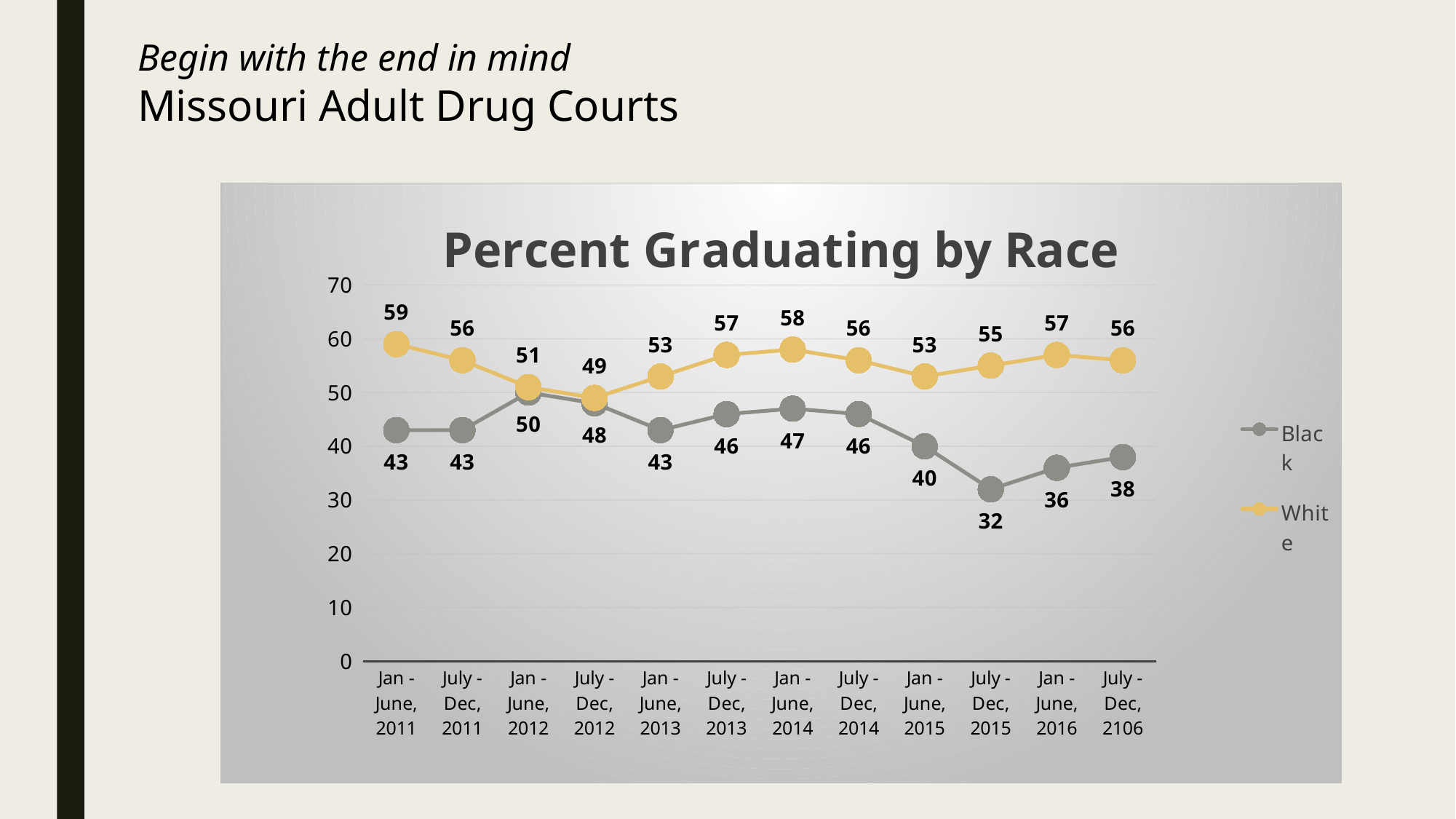
What is the value for Black in July - Dec, 2015? 32 What is the value for White in Jan - June, 2011? 59 How many series does the legend list? 2 What kind of chart is shown on the slide? line chart Does the Black series rise or fall from Jan - June, 2014 to July - Dec, 2015? fall In which period is the Black series at its lowest? July - Dec, 2015 How many time periods are plotted along the x axis? 12 Which series has the higher value in July - Dec, 2012, Black or White? White What is the difference between the White and Black values in July - Dec, 2015? 23 In which period is the White series at its lowest? July - Dec, 2012 What is the value for Black in Jan - June, 2012? 50 What is the chart's title? Percent Graduating by Race